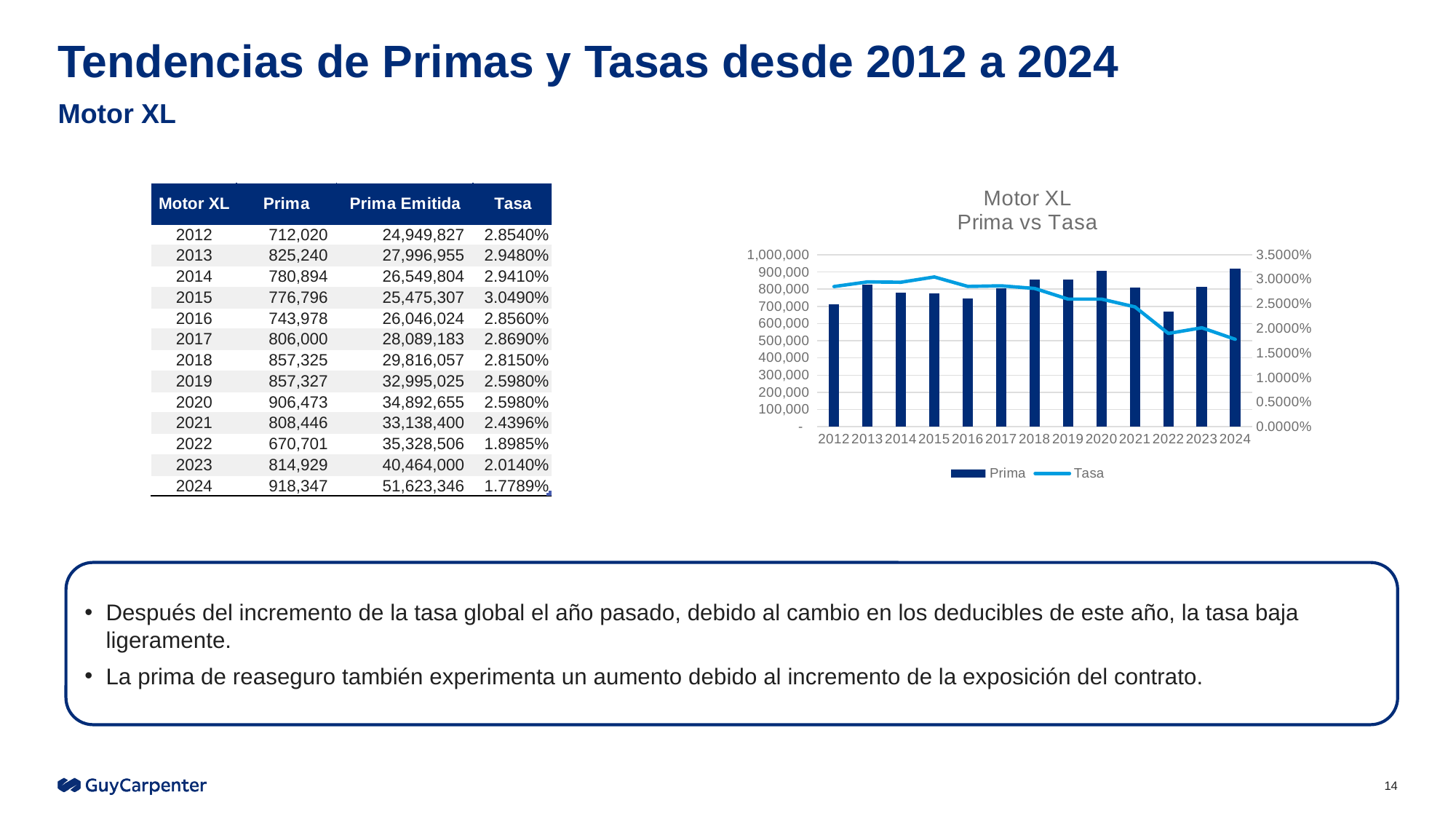
What is the difference between the Prima values for 2024 and 2023 in the Motor XL data? 103,418 In the 'Motor XL Prima vs Tasa' chart, which year has the highest Tasa value? 2015 How many years are shown on the x axis of the 'Motor XL Prima vs Tasa' chart? 13 In the 'Motor XL Prima vs Tasa' chart, which year has the lowest Tasa value? 2024 What is the Tasa value for 2022 in the Motor XL data? 1.8985% In the 'Motor XL Prima vs Tasa' chart, which year has the lowest Prima bar? 2022 How many series does the legend of the 'Motor XL Prima vs Tasa' chart list? 2 In the 'Motor XL Prima vs Tasa' chart, is the Prima value for 2012 greater or less than 800,000? less In the 'Motor XL Prima vs Tasa' chart, does the Tasa line generally rise or fall from 2015 to 2024? fall In the 'Motor XL Prima vs Tasa' chart, which year has the larger Prima bar, 2016 or 2018? 2018 What is the Prima value for 2020 in the Motor XL data? 906,473 What kind of chart is the 'Motor XL Prima vs Tasa' chart? A combined bar and line chart